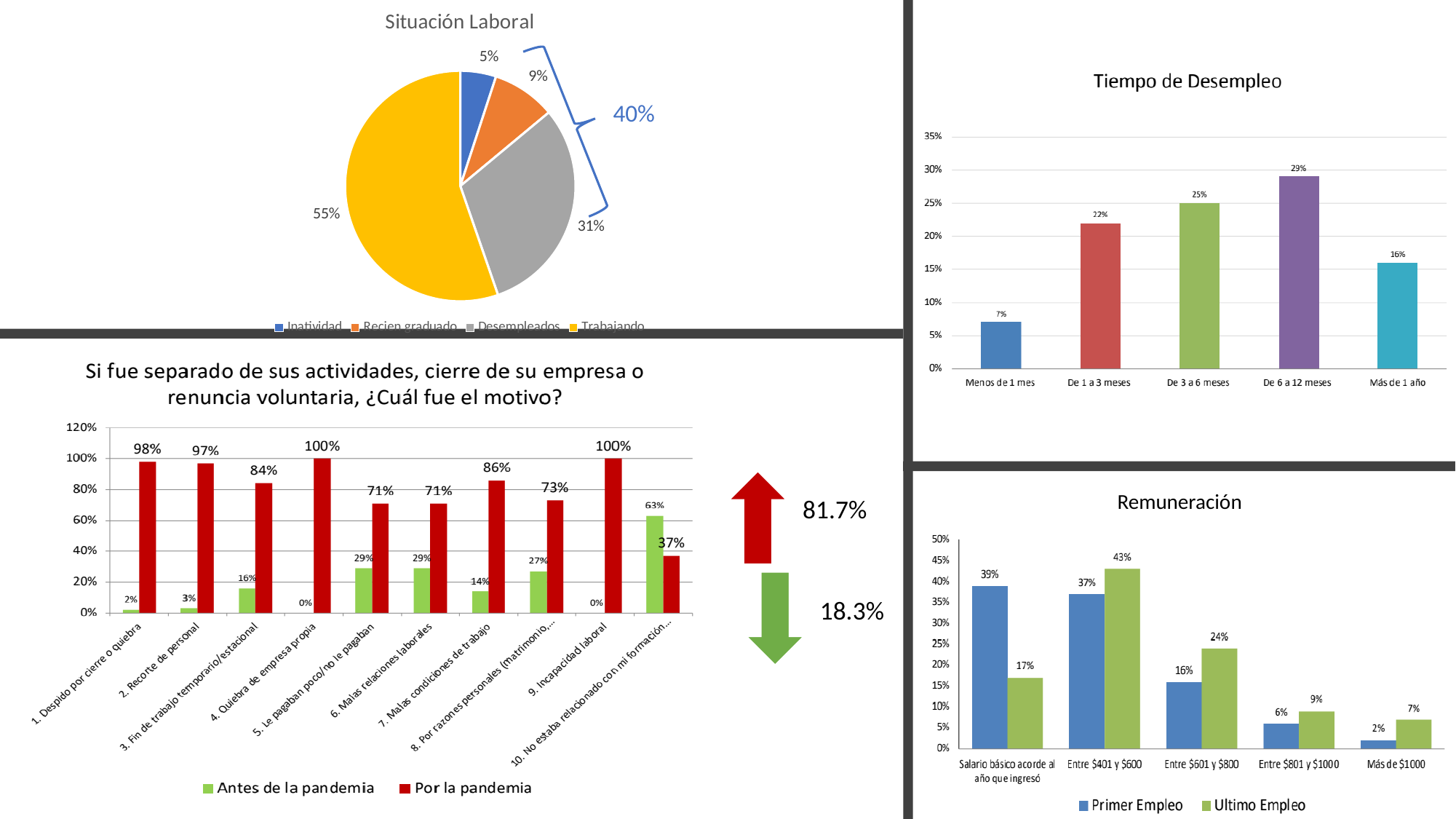
In the 'Tiempo de Desempleo' chart, what is the value for 'Menos de 1 mes'? 7% How many categories does the 'Tiempo de Desempleo' chart show? 5 In the bottom-left chart about the reason for separation, what is the 'Por la pandemia' value for '2. Recorte de personal'? 97% How many series does the legend of the 'Remuneración' chart list? 2 In the 'Situación Laboral' pie chart, what share is labelled 'Desempleados'? 31% In the 'Remuneración' chart, what is the 'Ultimo Empleo' value for 'Entre $401 y $600'? 43% In the 'Situación Laboral' pie chart, what share is labelled 'Trabajando'? 55% In the 'Remuneración' chart, which is larger for 'Salario básico acorde al año que ingresó': Primer Empleo or Ultimo Empleo? Primer Empleo What kind of chart is 'Situación Laboral'? Pie chart In the bottom-left chart about the reason for separation, what is the 'Antes de la pandemia' value for '10. No estaba relacionado con mi formación...'? 63% In the 'Tiempo de Desempleo' chart, what is the difference between 'De 3 a 6 meses' and 'Más de 1 año'? 9% In the 'Tiempo de Desempleo' chart, which category has the highest value? De 6 a 12 meses